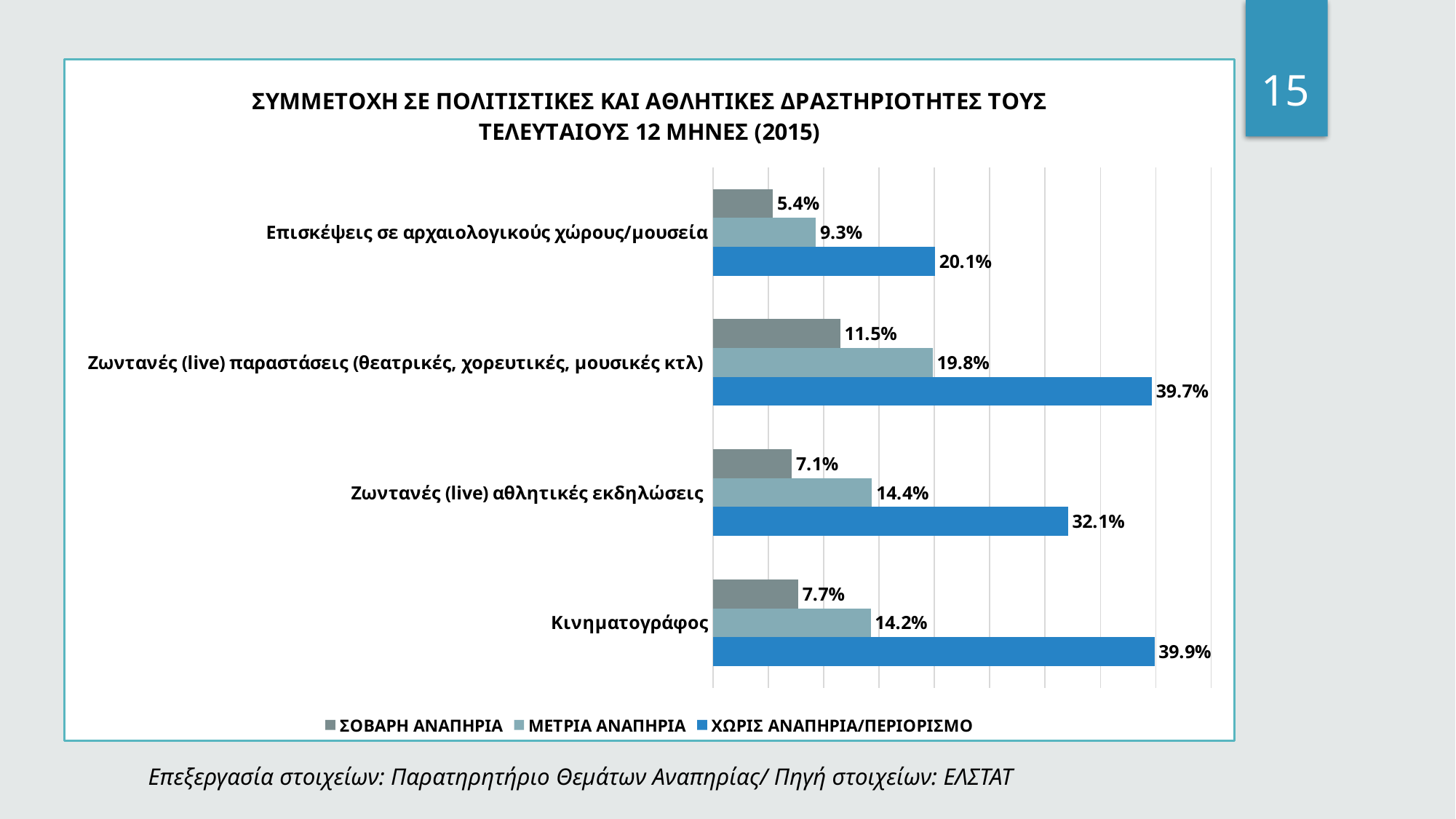
Which category has the highest value for ΣΟΒΑΡΗ ΑΝΑΠΗΡΙΑ? Ζωντανές (live) παραστάσεις (θεατρικές, χορευτικές, μουσικές κτλ) Which category has the lowest value for ΧΩΡΙΣ ΑΝΑΠΗΡΙΑ/ΠΕΡΙΟΡΙΣΜΟ? Επισκέψεις σε αρχαιολογικούς χώρους/μουσεία How many categories are shown on the chart? 4 What is the difference between the ΧΩΡΙΣ ΑΝΑΠΗΡΙΑ/ΠΕΡΙΟΡΙΣΜΟ and ΣΟΒΑΡΗ ΑΝΑΠΗΡΙΑ values for Ζωντανές (live) αθλητικές εκδηλώσεις? 25.0% Which is larger: the ΜΕΤΡΙΑ ΑΝΑΠΗΡΙΑ value for Ζωντανές (live) παραστάσεις or for Κινηματογράφος? Ζωντανές (live) παραστάσεις How many series does the legend list? 3 Which series is shown in dark blue in the legend? ΧΩΡΙΣ ΑΝΑΠΗΡΙΑ/ΠΕΡΙΟΡΙΣΜΟ What kind of chart is shown on the slide? Bar chart What is the value for ΜΕΤΡΙΑ ΑΝΑΠΗΡΙΑ in the category Ζωντανές (live) αθλητικές εκδηλώσεις? 14.4% What is the value for ΣΟΒΑΡΗ ΑΝΑΠΗΡΙΑ in the category Επισκέψεις σε αρχαιολογικούς χώρους/μουσεία? 5.4% What is the value for ΧΩΡΙΣ ΑΝΑΠΗΡΙΑ/ΠΕΡΙΟΡΙΣΜΟ in the category Κινηματογράφος? 39.9% What is the difference between the ΜΕΤΡΙΑ ΑΝΑΠΗΡΙΑ and ΣΟΒΑΡΗ ΑΝΑΠΗΡΙΑ values for Επισκέψεις σε αρχαιολογικούς χώρους/μουσεία? 3.9%